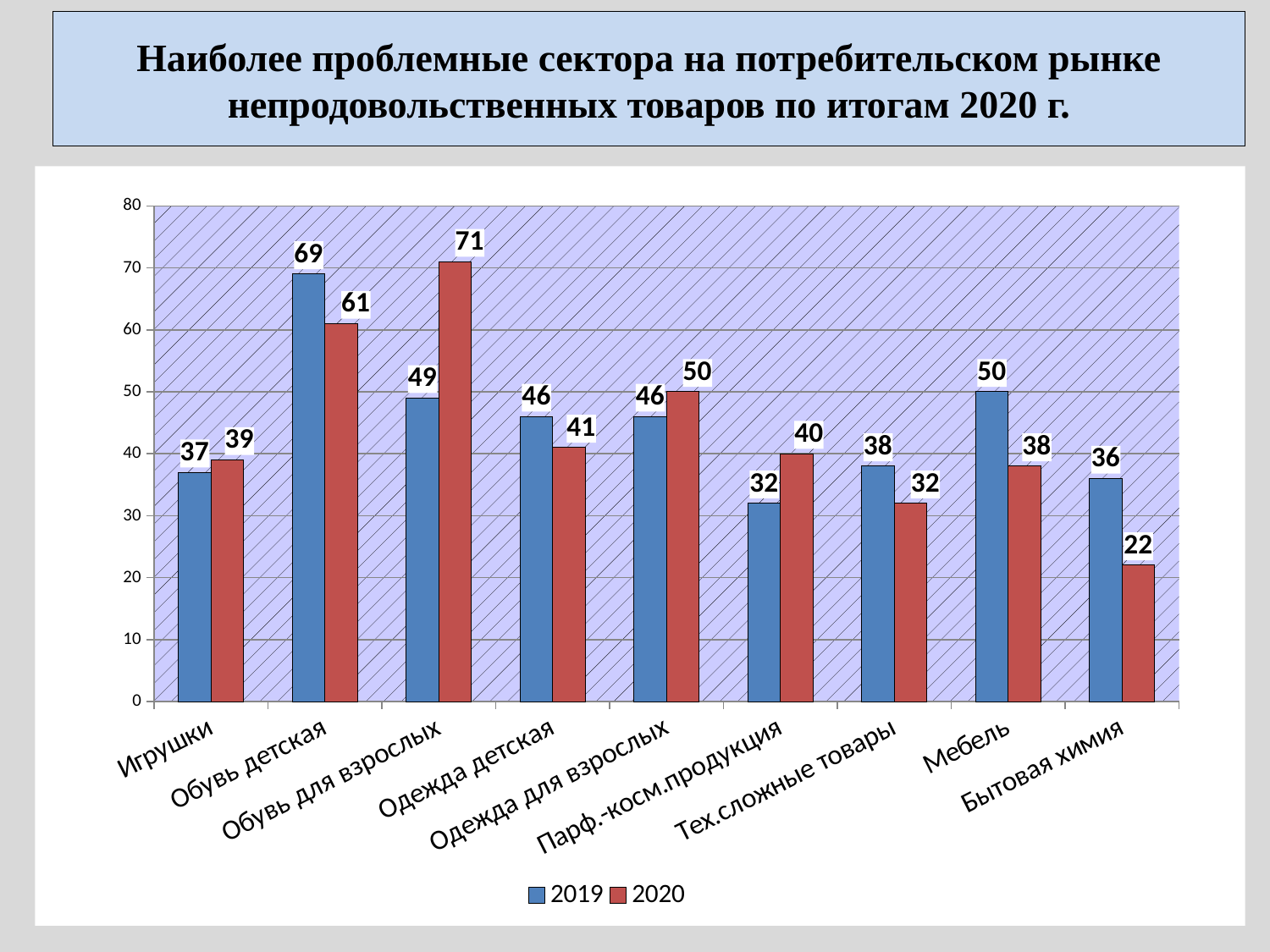
Which is larger for Одежда детская: the 2019 value or the 2020 value? 2019 Which category has the lowest value in 2020? Бытовая химия What kind of chart is shown on the slide? Bar chart Which category has the highest value in 2020? Обувь для взрослых How many series does the legend list? 2 Which category has the lowest value in 2019? Парф.-косм.продукция What is the difference between the 2020 and 2019 values for Обувь для взрослых? 22 What is the value for Бытовая химия in 2020? 22 What is the value for Обувь детская in 2019? 69 How many categories are shown on the x axis? 9 What is the difference between the 2019 and 2020 values for Мебель? 12 What is the value for Парф.-косм.продукция in 2020? 40